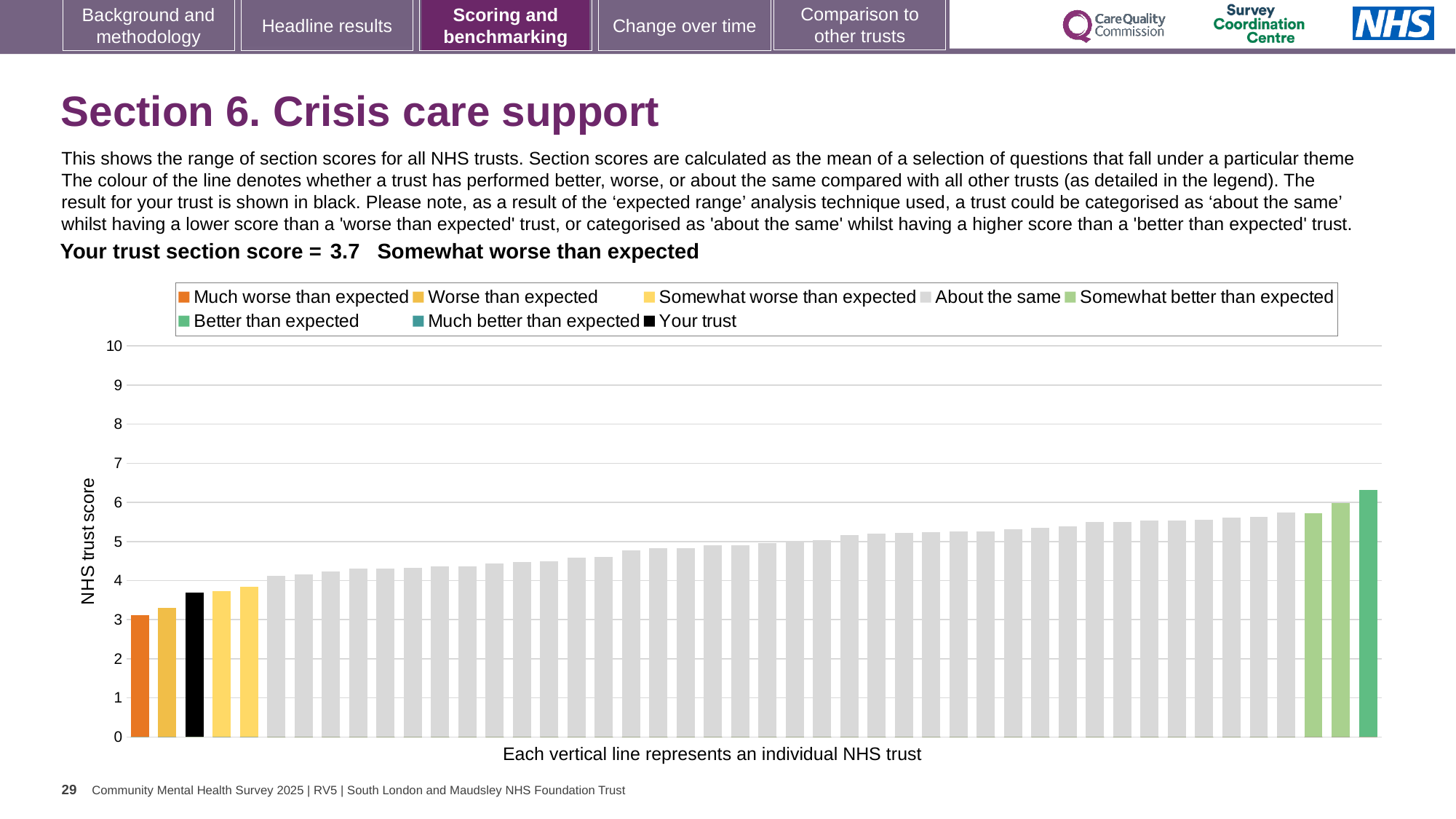
Which legend category does the tallest bar belong to? Better than expected Is the value of the shortest bar in the chart greater or less than 4? less What kind of chart is shown on the slide? Bar chart How many entries does the chart legend list? 8 Is the value of the tallest bar in the chart greater or less than 6? greater What is the label on the y axis of the chart? NHS trust score How many bars are coloured as 'Somewhat better than expected'? 2 Which legend category does your trust fall into for this section? Somewhat worse than expected Is the value of the 'Your trust' bar greater or less than 4? less What is the section score for your trust? 3.7 Do the bar values rise or fall from left to right along the x axis? Rise Which legend category does the shortest bar belong to? Much worse than expected